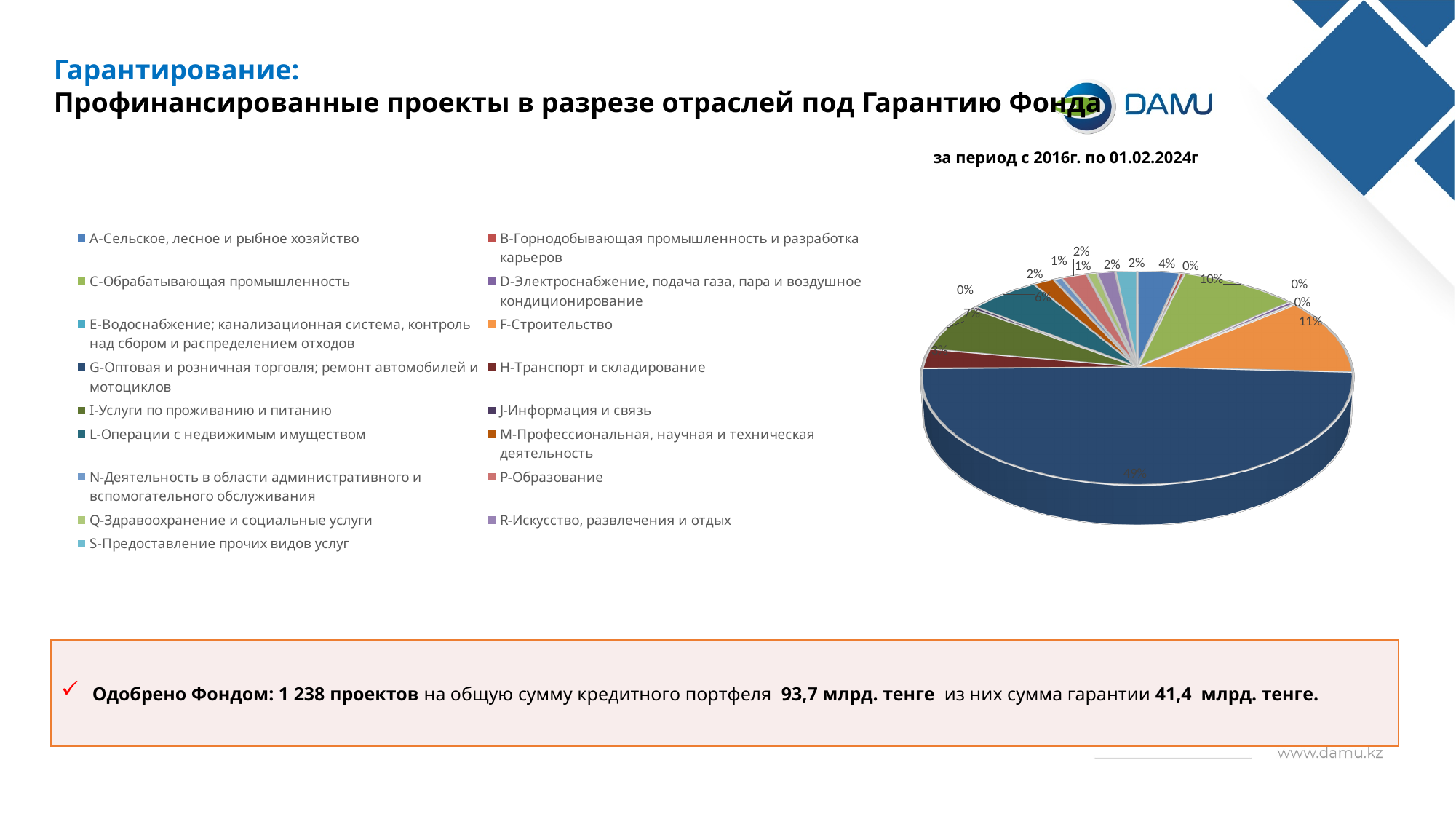
What share of the pie does I-Услуги по проживанию и питанию have? 7% How many categories does the legend of the pie chart list? 17 What share of the pie does C-Обрабатывающая промышленность have? 10% What kind of chart is shown on the slide? pie chart What is the difference between the shares of F-Строительство and C-Обрабатывающая промышленность? 1% What share of the pie does A-Сельское, лесное и рыбное хозяйство have? 4% Which has a larger share: F-Строительство or C-Обрабатывающая промышленность? F-Строительство Which has a larger share: C-Обрабатывающая промышленность or A-Сельское, лесное и рыбное хозяйство? C-Обрабатывающая промышленность What is the title of the slide containing the pie chart? Гарантирование: Профинансированные проекты в разрезе отраслей под Гарантию Фонда Which category has the largest share of the pie chart? G-Оптовая и розничная торговля; ремонт автомобилей и мотоциклов What period does the chart cover, according to the text above it? за период с 2016г. по 01.02.2024г What share of the pie does F-Строительство have? 11%